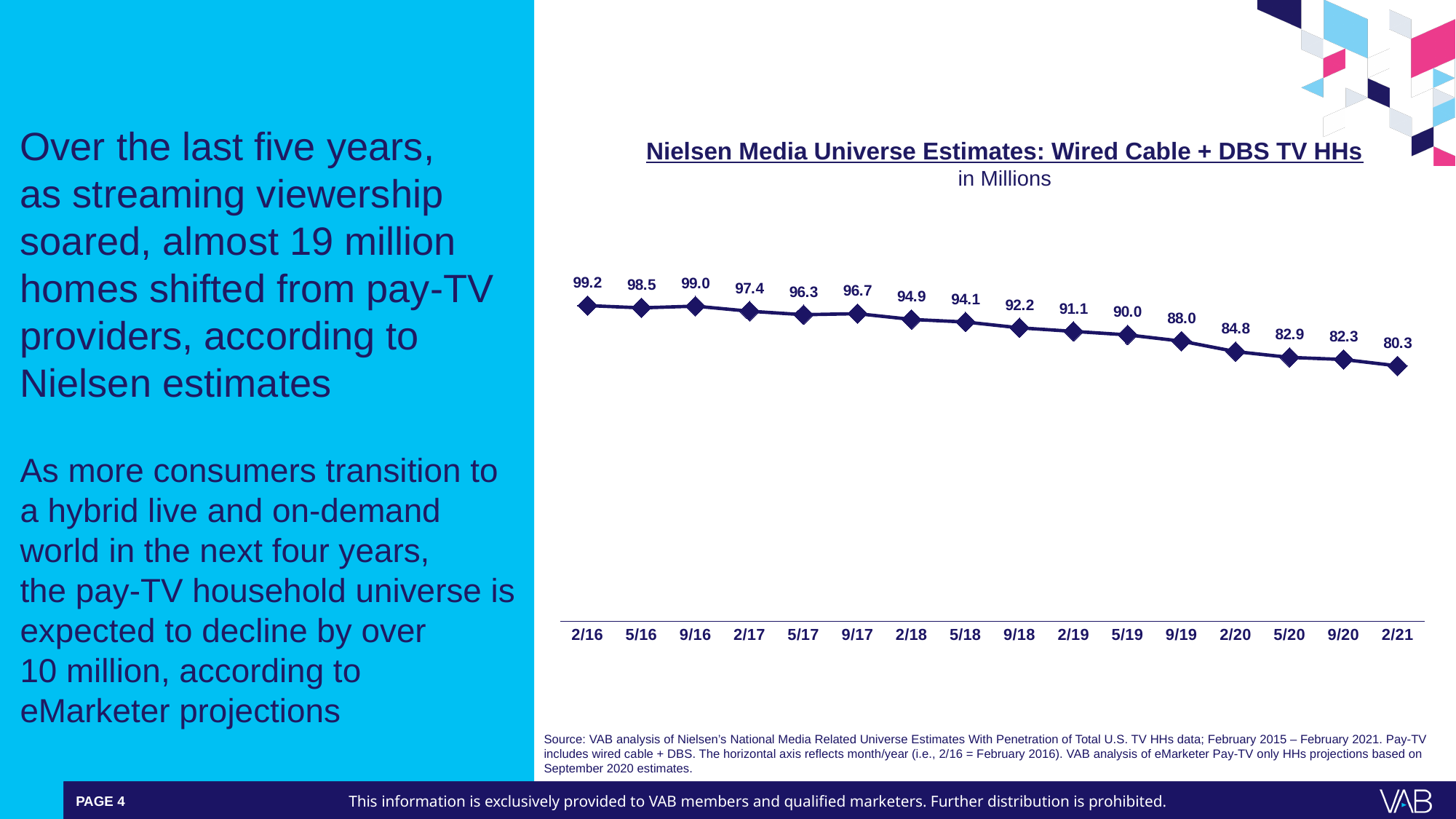
What is the value for 9/19? 88.0 What is the difference between the values for 9/19 and 2/20? 3.2 Which point on the x axis has the highest value? 2/16 Which is larger, the value for 5/16 or the value for 9/16? 9/16 What unit does the chart subtitle say the values are in? Millions What is the difference between the values for 2/16 and 2/21? 18.9 Do the values generally rise or fall from 2/16 to 2/21? fall What kind of chart is shown on the slide? line chart What is the value for 2/21? 80.3 What is the value for 2/16? 99.2 How many data points are plotted on the chart? 16 Which point on the x axis has the lowest value? 2/21